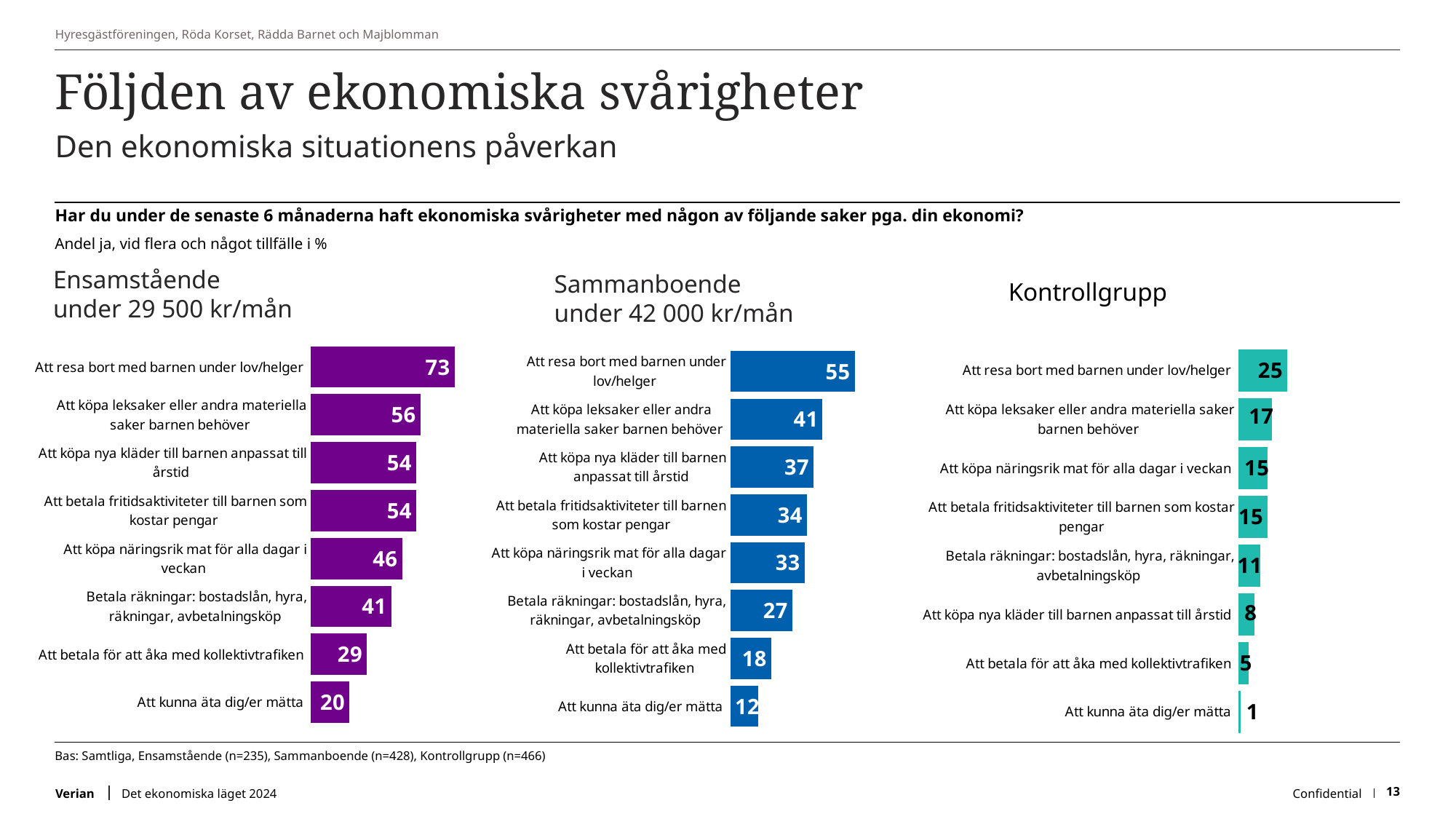
In the 'Kontrollgrupp' chart, which category has the lowest value? Att kunna äta dig/er mätta How many categories are shown in the 'Kontrollgrupp' chart? 8 In the 'Sammanboende under 42 000 kr/mån' chart, what is the difference between 'Att köpa leksaker eller andra materiella saker barnen behöver' and 'Att köpa nya kläder till barnen anpassat till årstid'? 4 What type of chart is the 'Ensamstående under 29 500 kr/mån' chart? Bar chart In the 'Ensamstående under 29 500 kr/mån' chart, what is the value for 'Att resa bort med barnen under lov/helger'? 73 In the 'Kontrollgrupp' chart, what is the value for 'Att betala för att åka med kollektivtrafiken'? 5 In the 'Ensamstående under 29 500 kr/mån' chart, what is the difference between 'Att resa bort med barnen under lov/helger' and 'Att kunna äta dig/er mätta'? 53 What colour are the bars in the 'Sammanboende under 42 000 kr/mån' chart? Blue Which is larger: the value for 'Betala räkningar: bostadslån, hyra, räkningar, avbetalningsköp' in the 'Ensamstående under 29 500 kr/mån' chart or in the 'Sammanboende under 42 000 kr/mån' chart? Ensamstående under 29 500 kr/mån In the 'Kontrollgrupp' chart, what is the value for 'Att köpa nya kläder till barnen anpassat till årstid'? 8 In the 'Sammanboende under 42 000 kr/mån' chart, what is the value for 'Att betala fritidsaktiviteter till barnen som kostar pengar'? 34 In the 'Sammanboende under 42 000 kr/mån' chart, which category has the highest value? Att resa bort med barnen under lov/helger